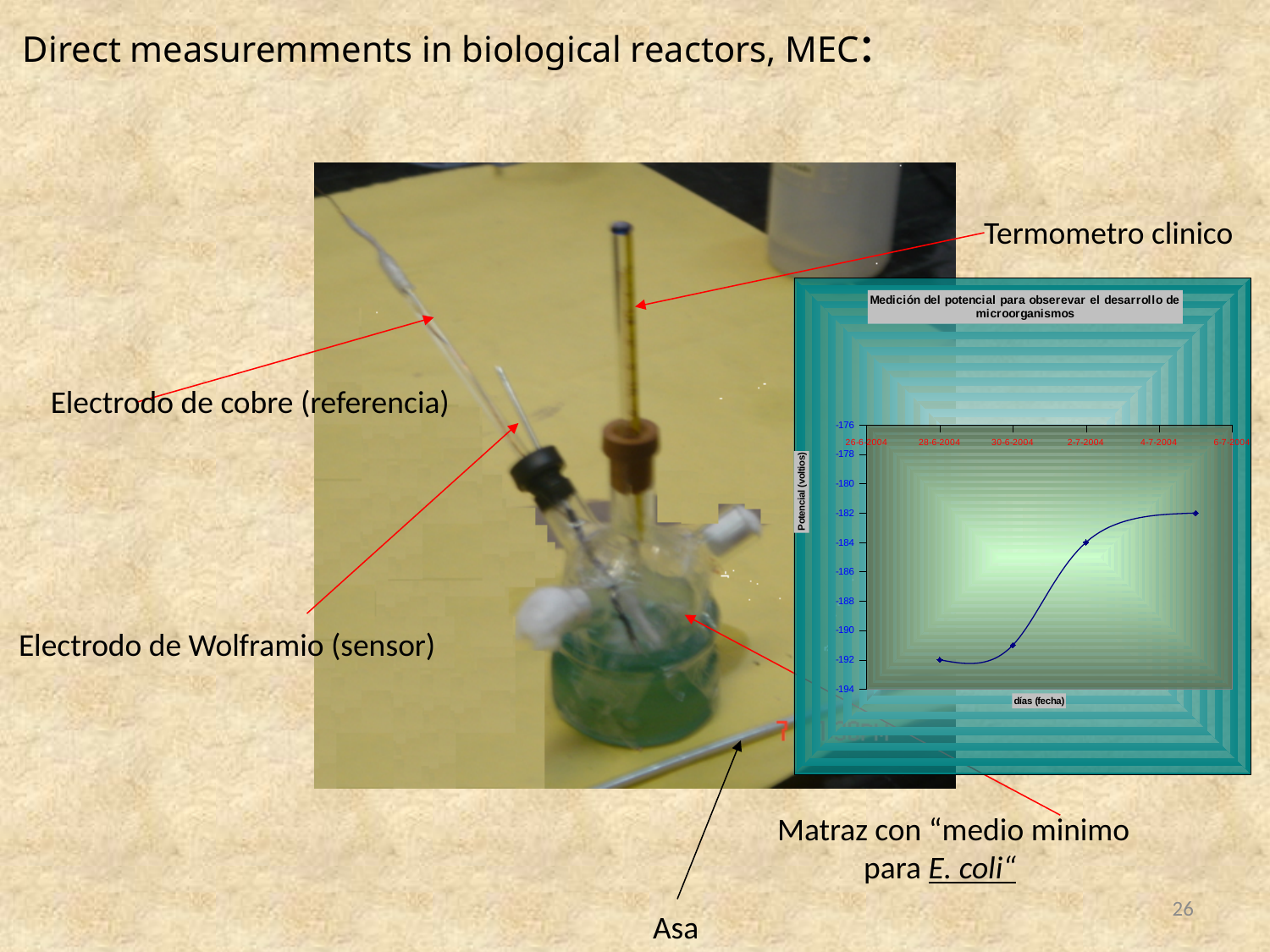
Is the potential value of the second data point greater or less than -188? less What is the potential value of the first (leftmost) data point on the chart? -192 What kind of chart is shown on the slide? line chart How many data points are plotted on the line in the chart? 4 What is the label of the y axis of the chart? Potencial (voltios) What is the potential value of the last (rightmost) data point on the chart? -182 What is the difference between the potential of the last data point and the first data point? 10 What is the lowest potential value plotted on the chart? -192 Which data point has the highest potential value, the first or the last? the last Do the plotted potential values rise or fall from left to right along the x axis? rise What is the title of the chart on the slide? Medición del potencial para obserevar el desarrollo de microorganismos What is the potential value of the third data point, near 2-7-2004? -184